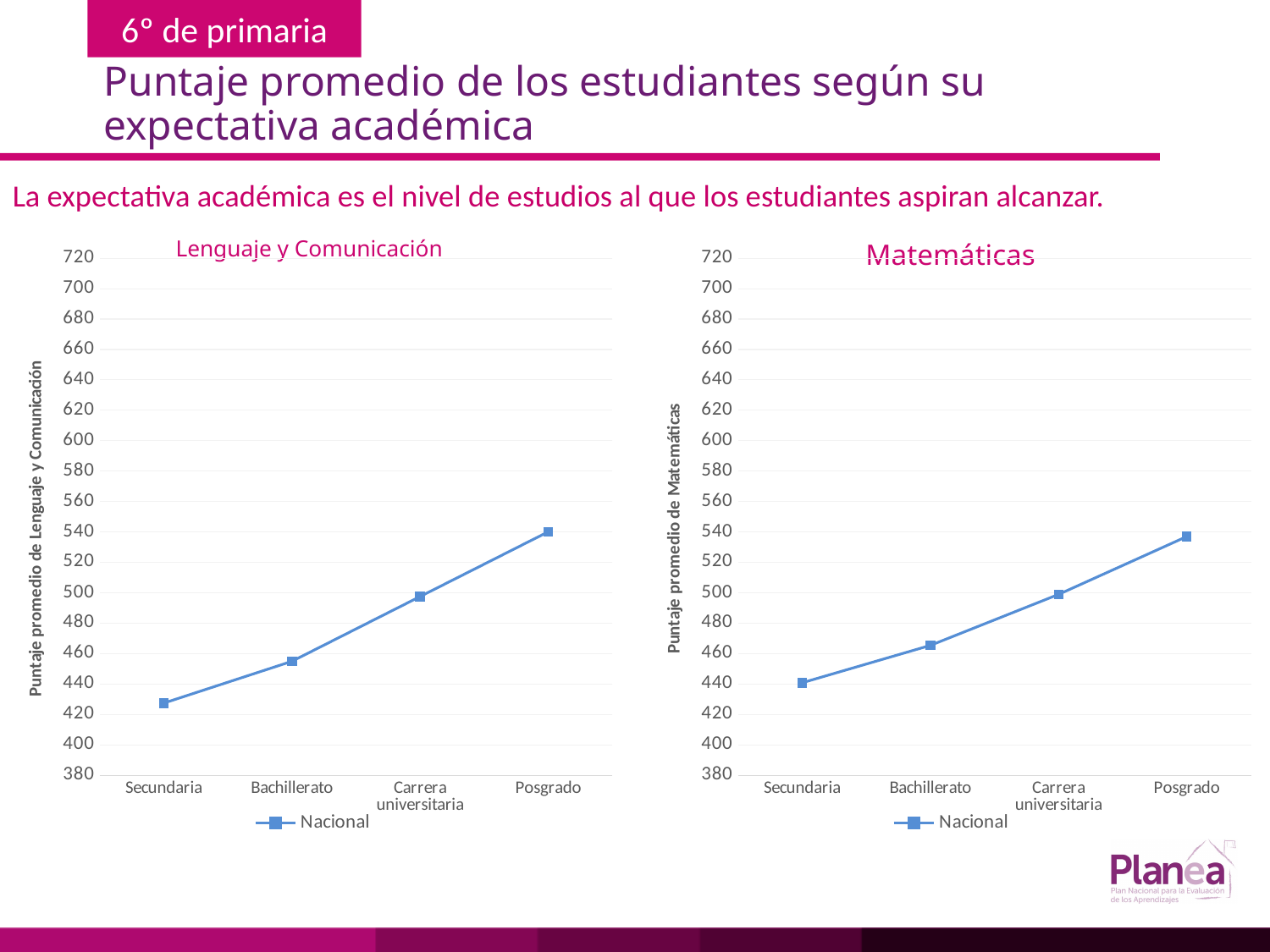
What is the name of the series shown in the legend of the Matemáticas chart? Nacional What is the y-axis label of the Lenguaje y Comunicación chart? Puntaje promedio de Lenguaje y Comunicación In the Matemáticas chart, is the value for Posgrado greater or less than 520? greater In the Lenguaje y Comunicación chart, which category has the highest value? Posgrado How many series does the legend of the Lenguaje y Comunicación chart list? 1 How many categories are shown on the x axis of the Matemáticas chart? 4 In the Matemáticas chart, is the value for Bachillerato greater or less than 480? less In the Lenguaje y Comunicación chart, is the value for Secundaria greater or less than 440? less In the Matemáticas chart, which category has the lowest value? Secundaria In the Lenguaje y Comunicación chart, which is larger, the value for Bachillerato or the value for Carrera universitaria? Carrera universitaria What kind of chart is the Lenguaje y Comunicación chart? line chart In the Matemáticas chart, do the values rise or fall from Secundaria to Posgrado? rise